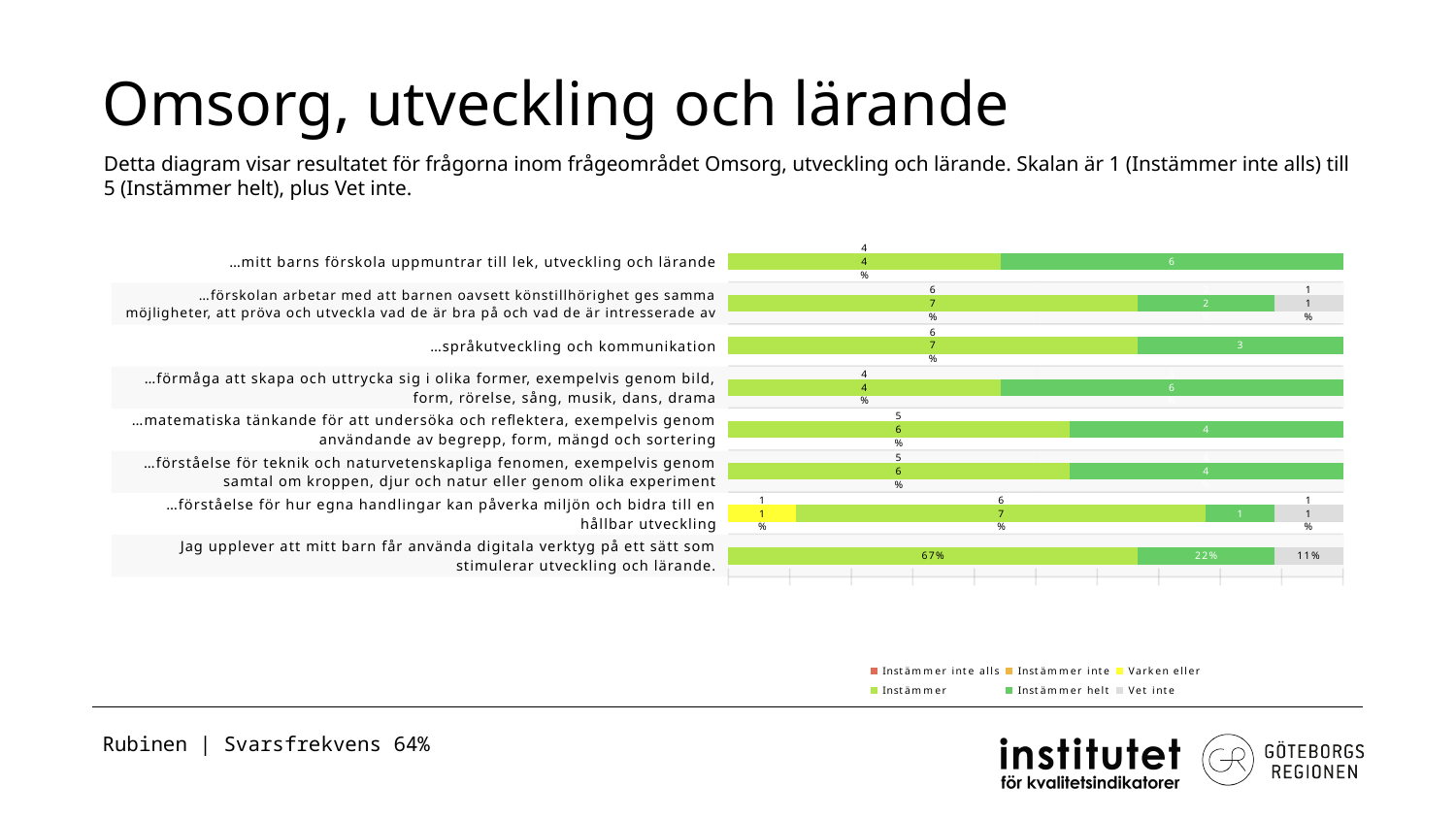
How many series does the legend list? 6 What is the total of the three labelled segments for 'Jag upplever att mitt barn får använda digitala verktyg på ett sätt som stimulerar utveckling och lärande.'? 100% What is the Vet inte share for 'Jag upplever att mitt barn får använda digitala verktyg på ett sätt som stimulerar utveckling och lärande.'? 11% Which legend entry is shown in yellow? Varken eller For the digital tools statement ('Jag upplever att mitt barn får använda digitala verktyg...'), which response category has the largest share? Instämmer What is the Instämmer share for '…språkutveckling och kommunikation'? 67% How many question statements (bars) are shown in the chart? 8 For the digital tools statement ('Jag upplever att mitt barn får använda digitala verktyg...'), what is the difference between the Instämmer share and the Instämmer helt share? 45 percentage points For the digital tools statement ('Jag upplever att mitt barn får använda digitala verktyg...'), which is larger: Instämmer helt or Vet inte? Instämmer helt What is the Instämmer helt share for 'Jag upplever att mitt barn får använda digitala verktyg på ett sätt som stimulerar utveckling och lärande.'? 22% What is the Instämmer share for 'Jag upplever att mitt barn får använda digitala verktyg på ett sätt som stimulerar utveckling och lärande.'? 67% What kind of chart is shown on the slide? Stacked bar chart